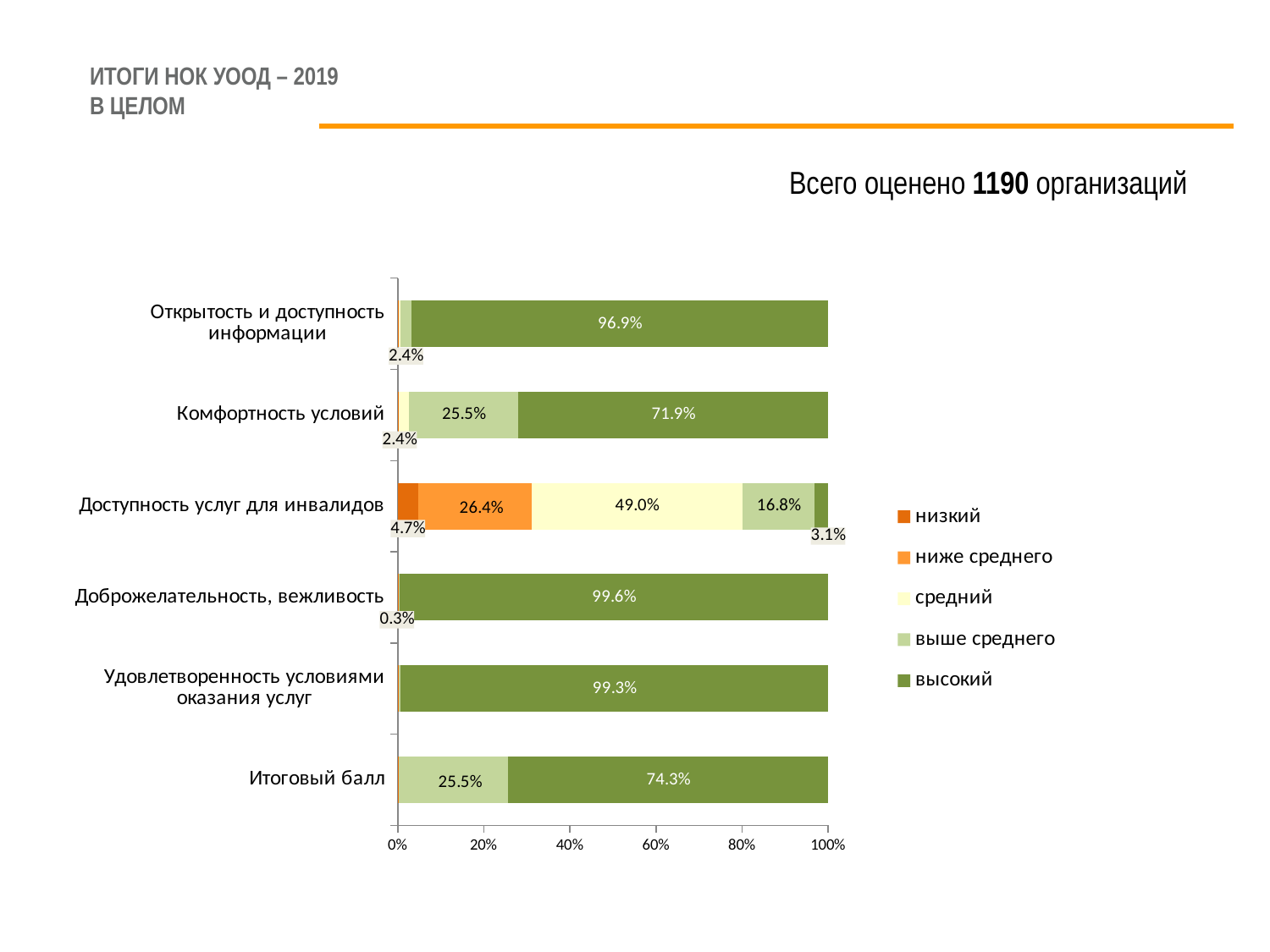
Which category has the lowest value for the "высокий" series? Доступность услуг для инвалидов How many categories are shown on the chart? 6 How many series does the legend list? 5 What kind of chart is shown on the slide? Stacked bar chart What is the value of the "высокий" series for "Доброжелательность, вежливость"? 99.6% What is the value of the "высокий" series for "Открытость и доступность информации"? 96.9% What is the value of the "ниже среднего" series for "Доступность услуг для инвалидов"? 26.4% What is the difference between the "высокий" values for "Итоговый балл" and "Комфортность условий"? 2.4% For "Доступность услуг для инвалидов", which is larger: the "средний" value or the "ниже среднего" value? средний What is the value of the "выше среднего" series for "Итоговый балл"? 25.5% What is the value of the "средний" series for "Доступность услуг для инвалидов"? 49.0% Which category has the highest value for the "высокий" series? Доброжелательность, вежливость